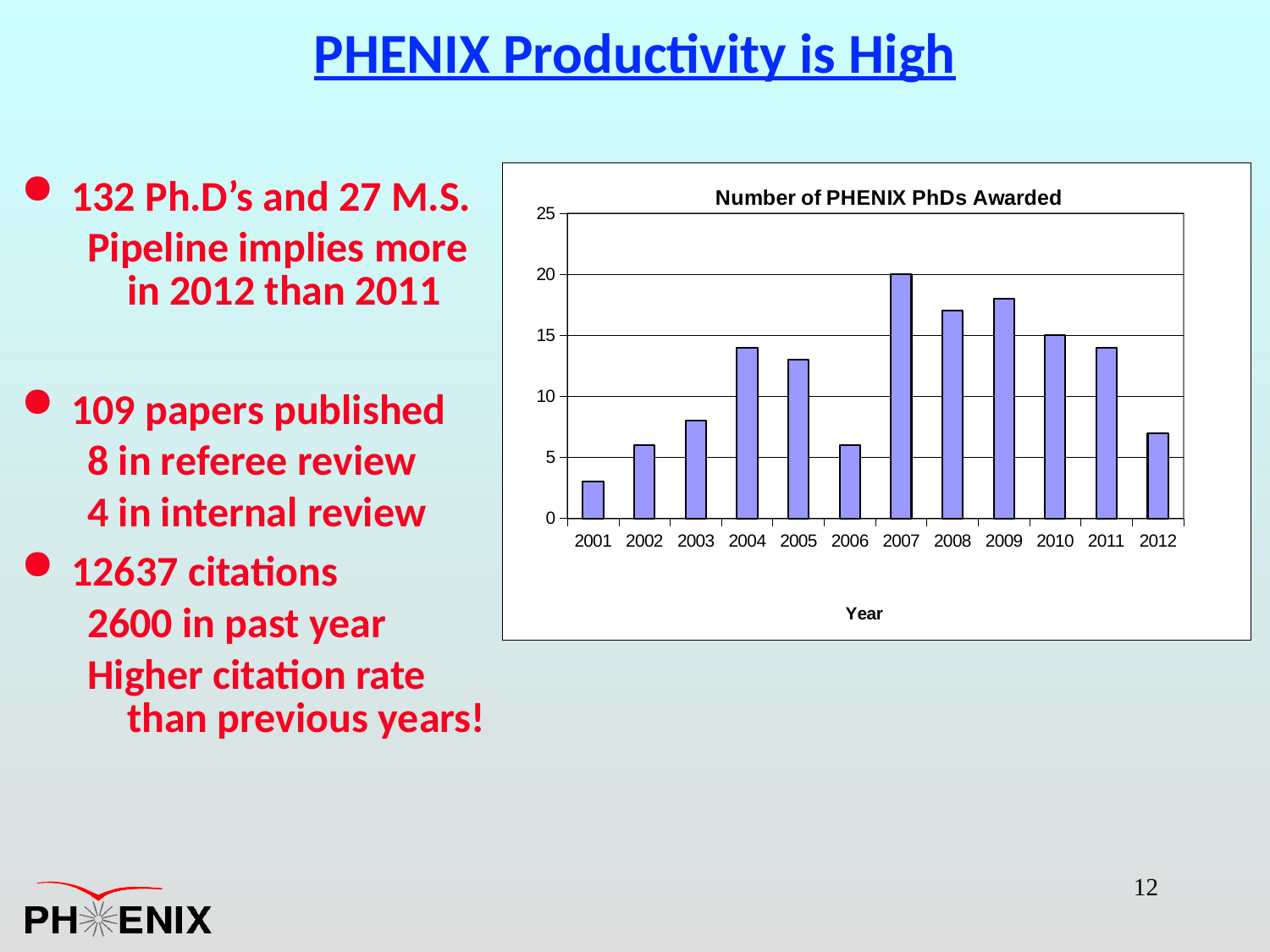
Which year had more PhDs awarded, 2007 or 2012? 2007 What type of chart is shown on the slide? bar chart Which year has the highest number of PHENIX PhDs awarded? 2007 How many years are shown on the x axis of the chart? 12 Is the number of PhDs awarded in 2004 greater or less than 10? greater Which year has the lowest number of PHENIX PhDs awarded? 2001 Is the number of PhDs awarded in 2001 greater or less than 5? less Is the number of PhDs awarded in 2008 greater or less than 15? greater What is the title of the chart? Number of PHENIX PhDs Awarded What is the label of the x axis of the chart? Year How many PHENIX PhDs were awarded in 2007? 20